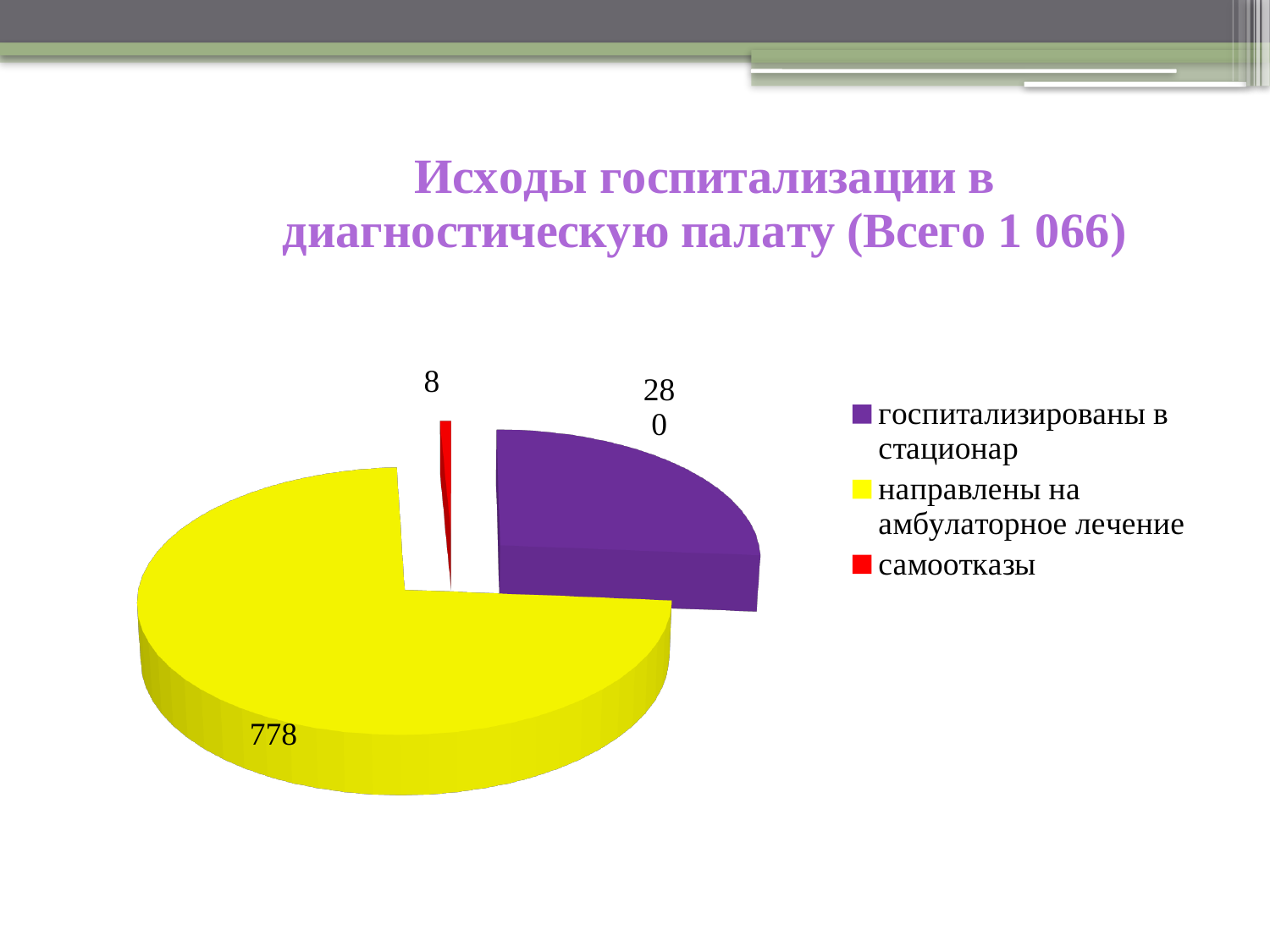
What value is shown for 'самоотказы' on the pie chart? 8 What colour represents 'самоотказы' in the pie chart? Red Which category has the smallest slice of the pie chart? самоотказы How many categories (slices) does the pie chart contain? 3 How many patients were hospitalized in the inpatient department (госпитализированы в стационар) according to the pie chart? 280 What total number of cases is stated in the chart title? 1 066 What type of chart is shown on the slide? Pie chart How many entries does the legend list? 3 What value is shown for the slice 'направлены на амбулаторное лечение'? 778 Which is larger: the value for 'госпитализированы в стационар' or the value for 'самоотказы'? госпитализированы в стационар What is the difference between the number sent to outpatient treatment (778) and the number hospitalized (280)? 498 Which category has the largest slice of the pie chart? направлены на амбулаторное лечение